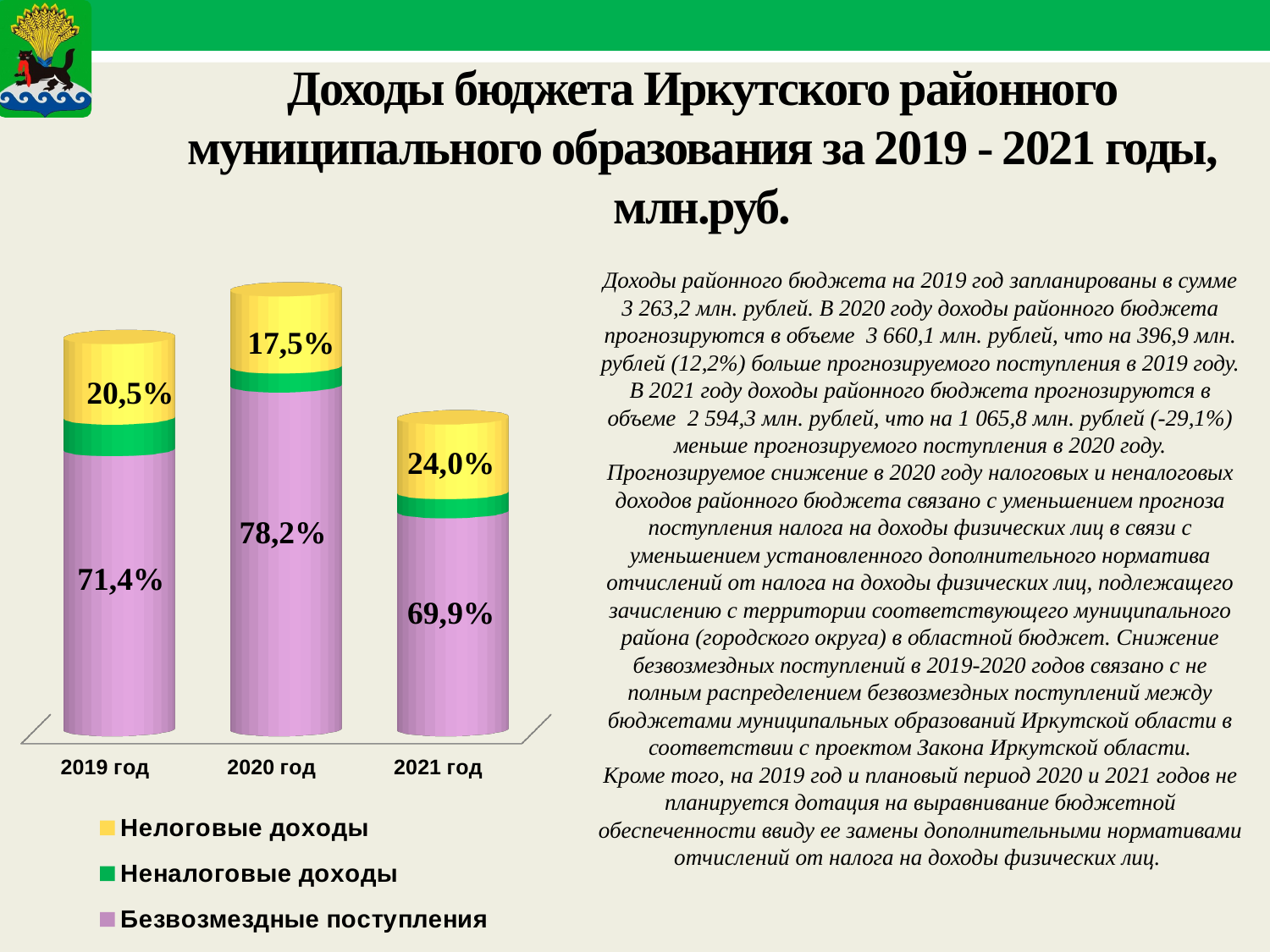
What is the share of the yellow (Нелоговые доходы) segment in 2021 год? 24,0% Which series is shown in green in the chart legend? Неналоговые доходы By how many percentage points does the share of Безвозмездные поступления in 2020 год exceed that in 2019 год? 6,8% What is the share of the yellow (Нелоговые доходы) segment in 2020 год? 17,5% What is the share of Безвозмездные поступления in 2020 год? 78,2% How many series does the chart legend list? 3 Which year has a larger share of the yellow (Нелоговые доходы) segment: 2019 год or 2021 год? 2021 год In which year is the share of the yellow (Нелоговые доходы) segment the lowest? 2020 год How many years (categories) are shown on the x axis of the chart? 3 What type of chart is shown on the slide? Stacked bar chart What is the share of Безвозмездные поступления in 2019 год? 71,4% In which year is the share of Безвозмездные поступления the highest? 2020 год